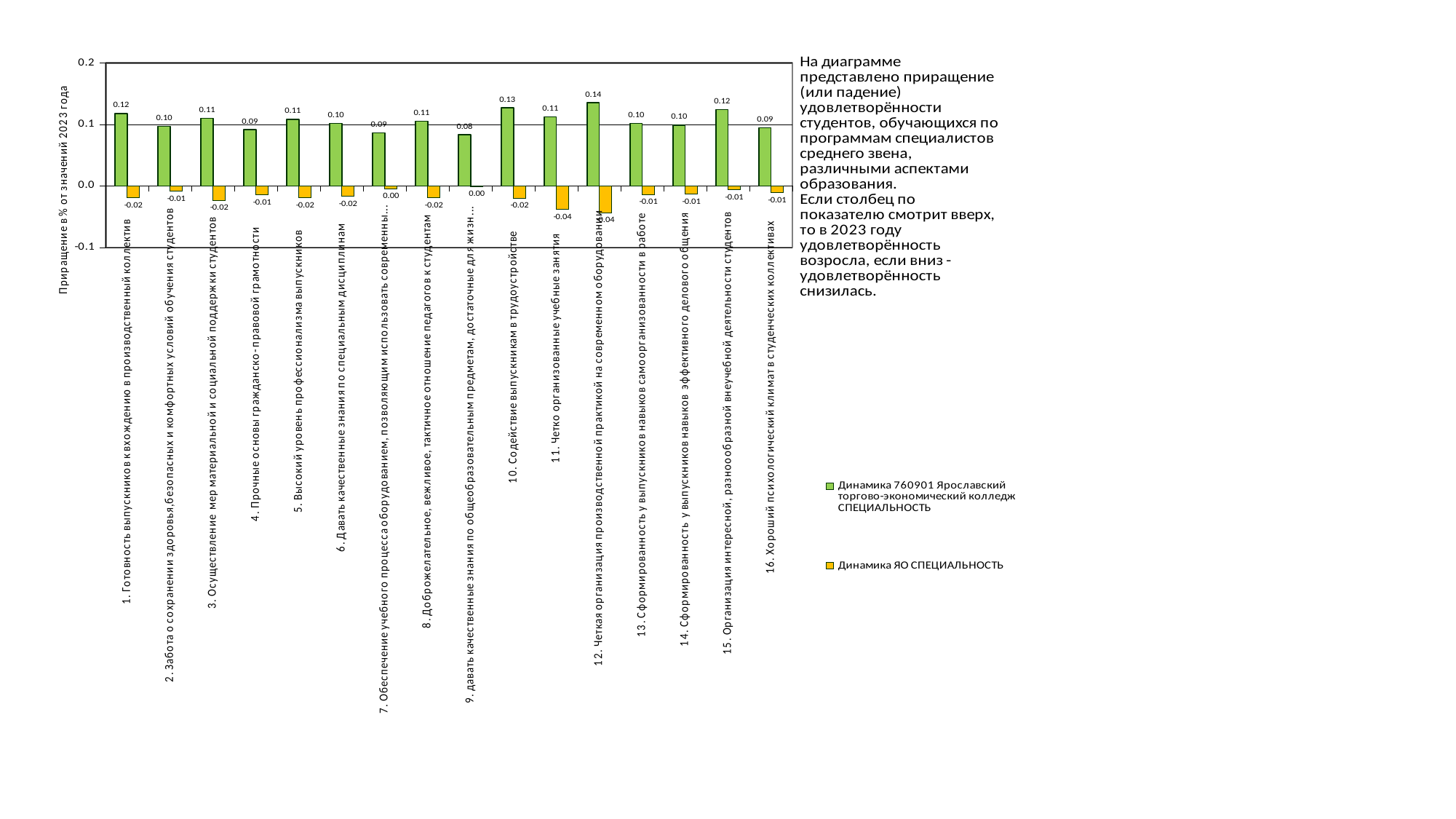
What is the value of the series 'Динамика ЯО СПЕЦИАЛЬНОСТЬ' for '14. Сформированность у выпускников навыков эффективного делового общения'? -0.01 What type of chart is shown on the slide? bar chart What is the value of the series 'Динамика ЯО СПЕЦИАЛЬНОСТЬ' for '11. Четко организованные учебные занятия'? -0.04 For the series 'Динамика 760901 Ярославский торгово-экономический колледж СПЕЦИАЛЬНОСТЬ', which is larger: '1. Готовность выпускников к вхождению в производственный коллектив' or '2. Забота о сохранении здоровья, безопасных и комфортных условий обучения студентов'? 1. Готовность выпускников к вхождению в производственный коллектив What is the title of the vertical axis of the chart? Приращение в % от значений 2023 года What is the difference between the green series values for category 12 (0.14) and category 9 (0.08)? 0.06 What is the value of the series 'Динамика 760901 Ярославский торгово-экономический колледж СПЕЦИАЛЬНОСТЬ' for '16. Хороший психологический климат в студенческих коллективах'? 0.09 Which category has the highest value for the series 'Динамика 760901 Ярославский торгово-экономический колледж СПЕЦИАЛЬНОСТЬ'? 12. Четкая организация производственной практикой на современном оборудовании Which numbered category has the lowest value for the series 'Динамика 760901 Ярославский торгово-экономический колледж СПЕЦИАЛЬНОСТЬ'? 9 How many categories are shown along the x axis of the chart? 16 What is the value of the series 'Динамика 760901 Ярославский торгово-экономический колледж СПЕЦИАЛЬНОСТЬ' for '10. Содействие выпускникам в трудоустройстве'? 0.13 How many series does the chart legend list? 2